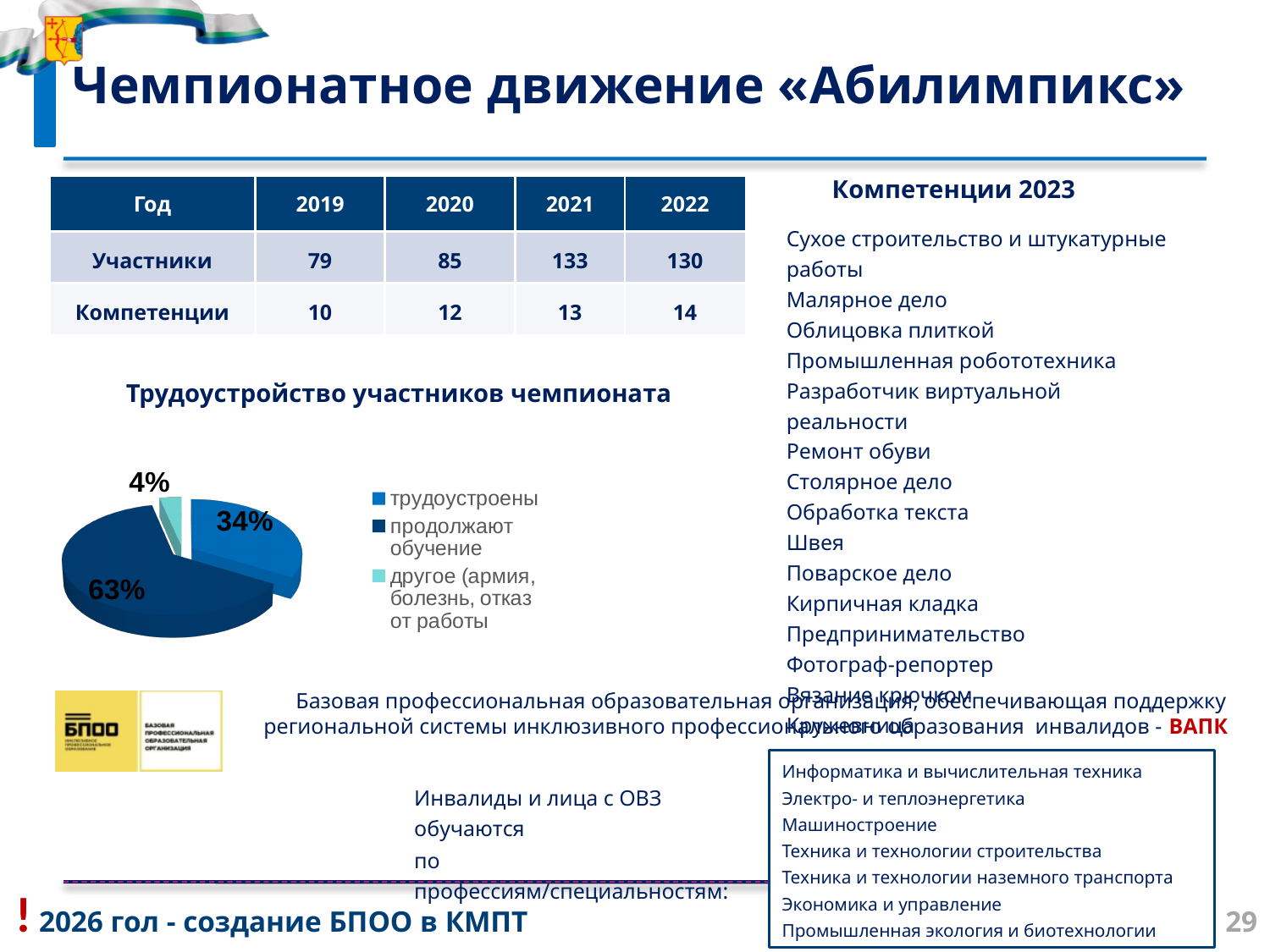
What kind of chart is shown under the heading «Трудоустройство участников чемпионата»? pie chart In the pie chart «Трудоустройство участников чемпионата», what colour is the slice for «другое (армия, болезнь, отказ от работы)»? light blue (cyan) In the pie chart «Трудоустройство участников чемпионата», which category has the largest slice? продолжают обучение How many entries does the legend of the pie chart «Трудоустройство участников чемпионата» list? 3 In the pie chart «Трудоустройство участников чемпионата», which is larger: «продолжают обучение» or «другое (армия, болезнь, отказ от работы)»? продолжают обучение In the pie chart «Трудоустройство участников чемпионата», what share is labelled for «продолжают обучение»? 63% How many slices does the pie chart «Трудоустройство участников чемпионата» have? 3 In the pie chart «Трудоустройство участников чемпионата», what share is labelled for «трудоустроены»? 34% What is the title of the pie chart on the slide? Трудоустройство участников чемпионата In the pie chart «Трудоустройство участников чемпионата», which category has the smallest slice? другое (армия, болезнь, отказ от работы) In the pie chart «Трудоустройство участников чемпионата», what share is labelled for «другое (армия, болезнь, отказ от работы)»? 4%